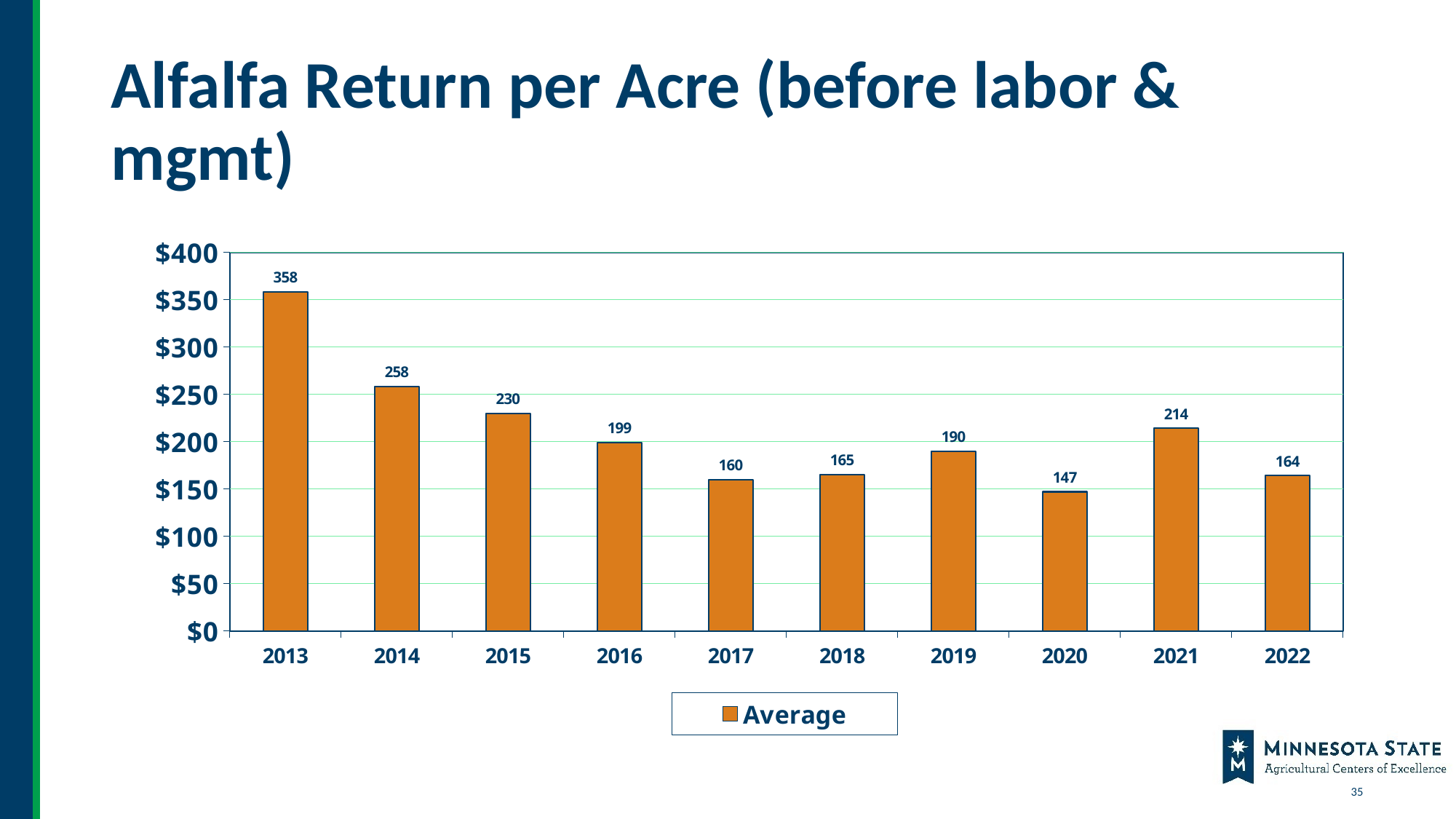
What kind of chart is shown on the slide? bar chart Which year has the lowest average alfalfa return per acre? 2020 What is the difference between the 2021 and 2022 average alfalfa return per acre? 50 What is the difference between the 2013 and 2014 average alfalfa return per acre? 100 What is the average alfalfa return per acre for 2020? 147 Which year has the highest average alfalfa return per acre? 2013 What is the average alfalfa return per acre for 2013? 358 How many years are shown on the x axis of the chart? 10 Which year has a larger average alfalfa return per acre, 2019 or 2021? 2021 What series name is listed in the chart legend? Average Is the value for 2016 greater or less than $250? less What is the average alfalfa return per acre for 2022? 164